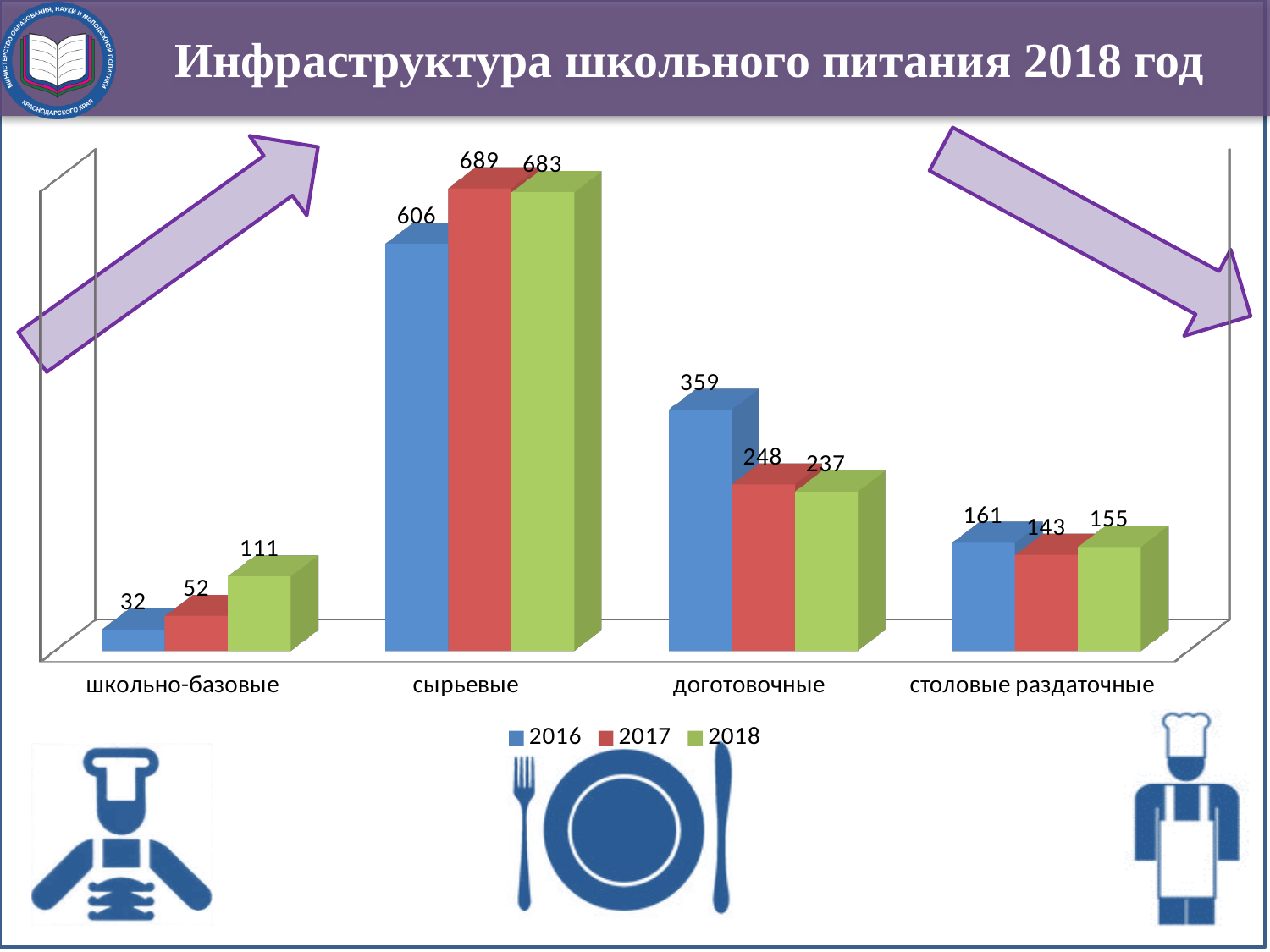
Which is larger for столовые раздаточные: the 2016 value or the 2018 value? 2016 Which category has the highest value in 2018? сырьевые Which category has the lowest value in 2016? школьно-базовые How many categories are shown on the x axis? 4 How many series does the legend list? 3 What is the value for школьно-базовые in 2018? 111 What is the difference between the 2018 and 2016 values for школьно-базовые? 79 What is the value for доготовочные in 2016? 359 What kind of chart is shown on the slide? bar chart What is the value for сырьевые in 2017? 689 What is the difference between the 2016 and 2018 values for доготовочные? 122 What is the value for столовые раздаточные in 2017? 143